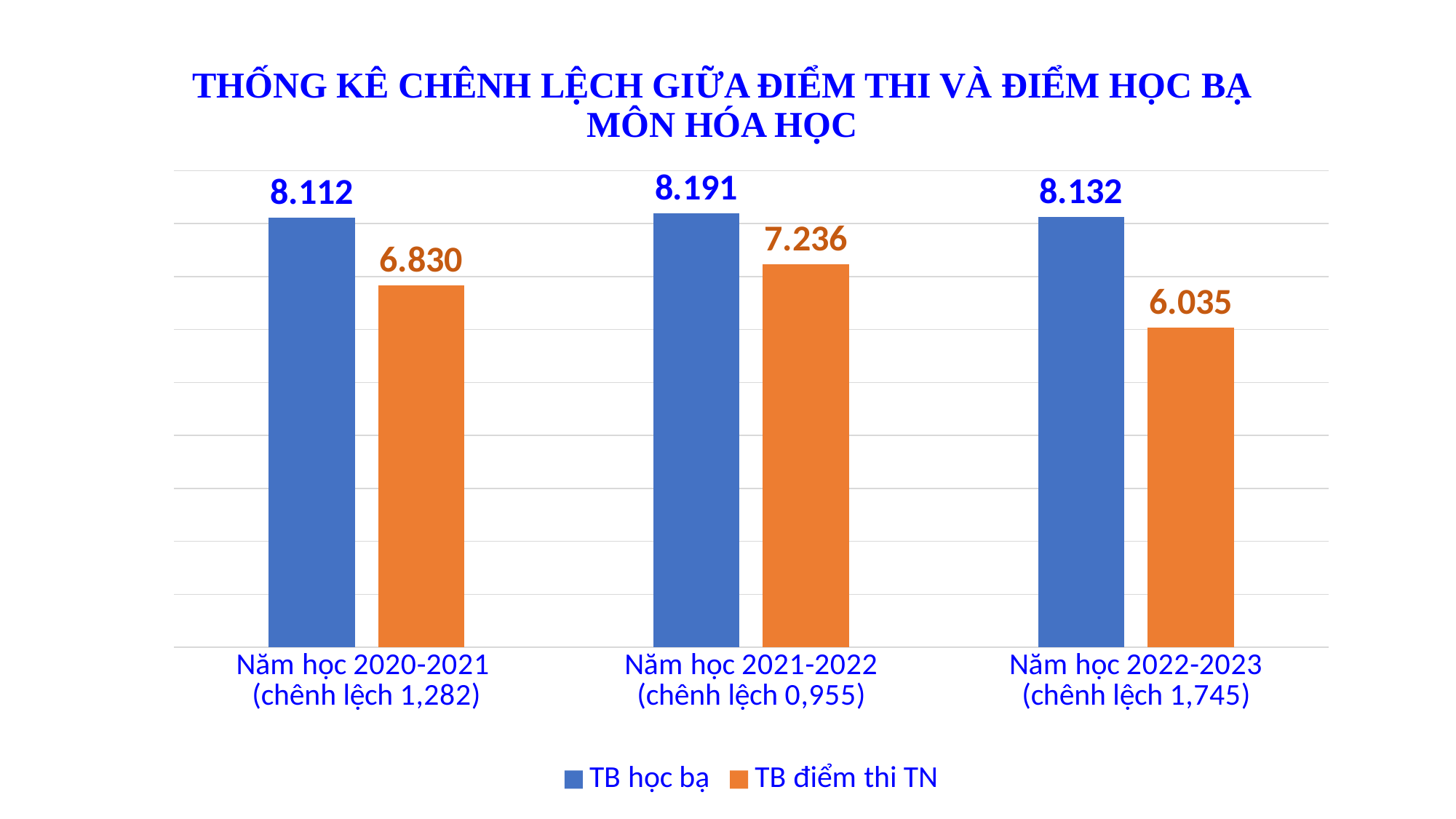
What is the difference between TB học bạ and TB điểm thi TN for Năm học 2020-2021? 1.282 What is the value of TB học bạ for Năm học 2020-2021? 8.112 What is the value of TB điểm thi TN for Năm học 2022-2023? 6.035 Which is larger for Năm học 2021-2022: TB học bạ or TB điểm thi TN? TB học bạ What colour are the TB điểm thi TN bars? Orange What is the value of TB học bạ for Năm học 2022-2023? 8.132 How many series does the legend list? 2 What kind of chart is shown on the slide? Bar chart Which school year has the lowest TB điểm thi TN value? Năm học 2022-2023 How many school years are shown on the chart? 3 Which school year has the highest TB học bạ value? Năm học 2021-2022 What is the value of TB điểm thi TN for Năm học 2021-2022? 7.236